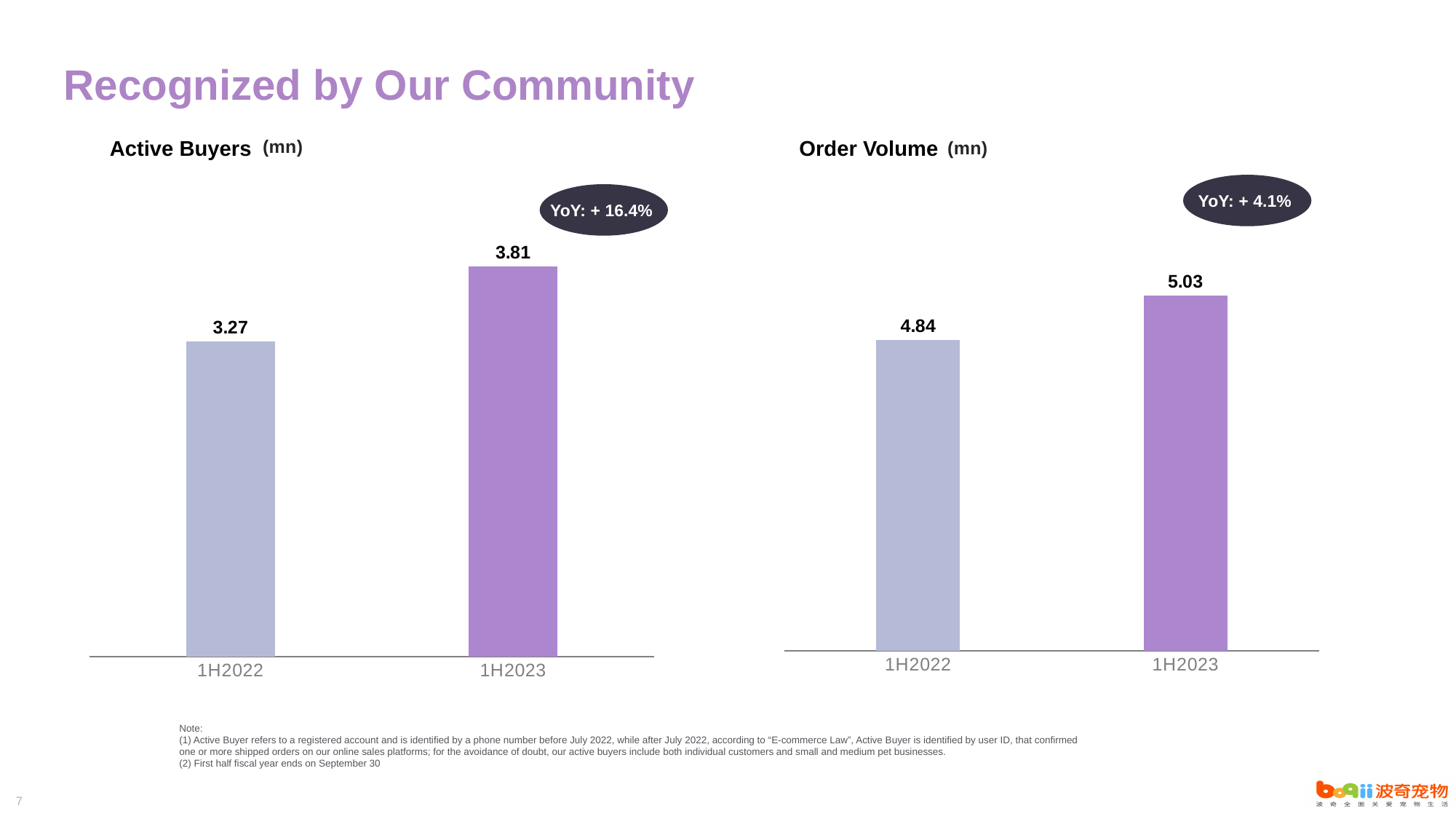
In the Active Buyers chart, what is the value for 1H2023? 3.81 In the Order Volume chart, which period has the lower value? 1H2022 In the Order Volume chart, what is the value for 1H2023? 5.03 How many bars are shown in the Active Buyers chart? 2 In the Order Volume chart, what is the difference between the 1H2023 and 1H2022 values? 0.19 In the Order Volume chart, is the value for 1H2023 larger or smaller than the value for 1H2022? larger What year-over-year change is shown for the Active Buyers chart? + 16.4% In the Active Buyers chart, what is the value for 1H2022? 3.27 What type of chart is the Order Volume chart? bar chart In the Active Buyers chart, what is the difference between the 1H2023 and 1H2022 values? 0.54 In the Active Buyers chart, which period has the higher value? 1H2023 In the Order Volume chart, what is the value for 1H2022? 4.84